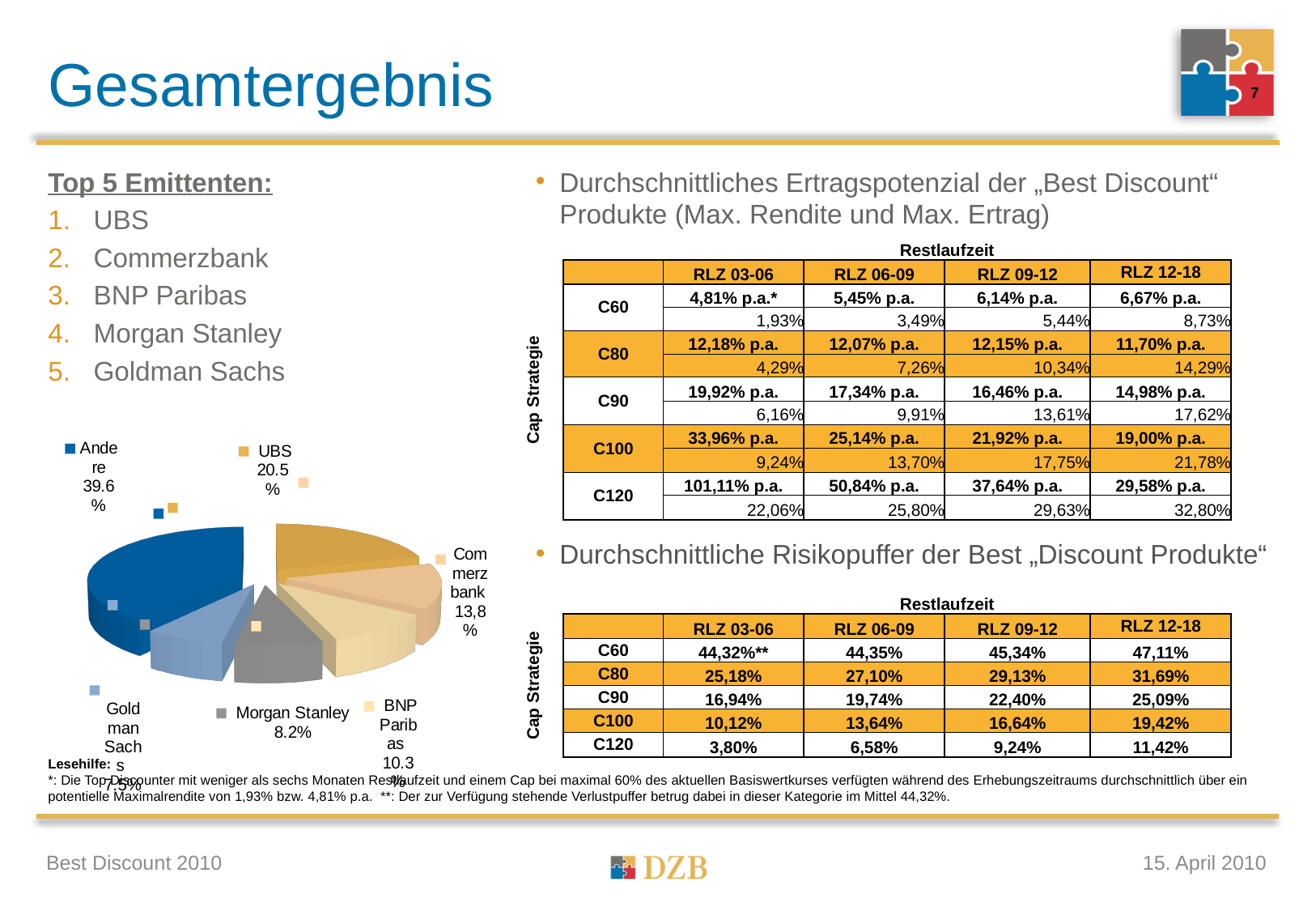
In the pie chart, what share does BNP Paribas have? 10.3% What kind of chart is shown on the left of the slide? pie chart In the pie chart, what share does Commerzbank have? 13,8% Which named issuer has the smallest slice in the pie chart? Goldman Sachs In the pie chart, which is larger: UBS or Commerzbank? UBS How many slices does the pie chart have? 6 In the pie chart, what share does Morgan Stanley have? 8.2% Which slice of the pie chart is the largest? Andere In the pie chart, what share does UBS have? 20.5% In the pie chart, which is larger: BNP Paribas or Morgan Stanley? BNP Paribas In the pie chart, how many percentage points larger is UBS's share than Morgan Stanley's? 12.3 What colour is the Andere slice in the pie chart? dark blue